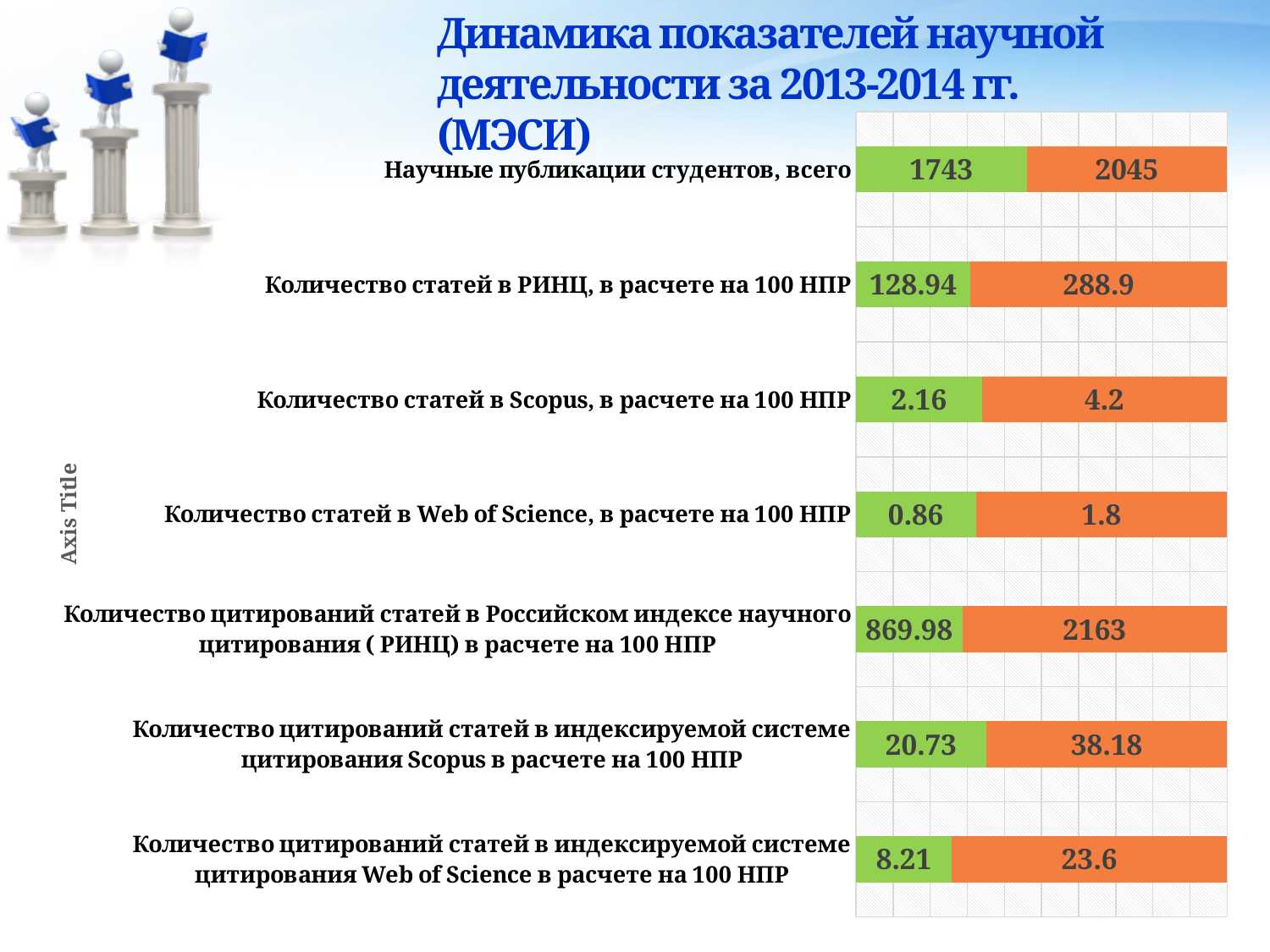
How many categories are shown in the chart? 7 What is the total of the two values in the bar for "Научные публикации студентов, всего"? 3788 What is the value shown in the orange segment for "Количество цитирований статей в индексируемой системе цитирования Scopus в расчете на 100 НПР"? 38.18 What is the value shown in the green segment for "Научные публикации студентов, всего"? 1743 What type of chart is shown on the slide? bar chart What text is shown as the vertical axis title of the chart? Axis Title What is the difference between the orange and green values for "Количество статей в Scopus, в расчете на 100 НПР"? 2.04 For "Количество цитирований статей в Российском индексе научного цитирования ( РИНЦ) в расчете на 100 НПР", which segment has the larger value, green or orange? orange What is the difference between the orange and green values for "Количество цитирований статей в индексируемой системе цитирования Web of Science в расчете на 100 НПР"? 15.39 What is the value shown in the orange segment for "Научные публикации студентов, всего"? 2045 What is the value shown in the orange segment for "Количество статей в РИНЦ, в расчете на 100 НПР"? 288.9 What is the value shown in the green segment for "Количество статей в Web of Science, в расчете на 100 НПР"? 0.86